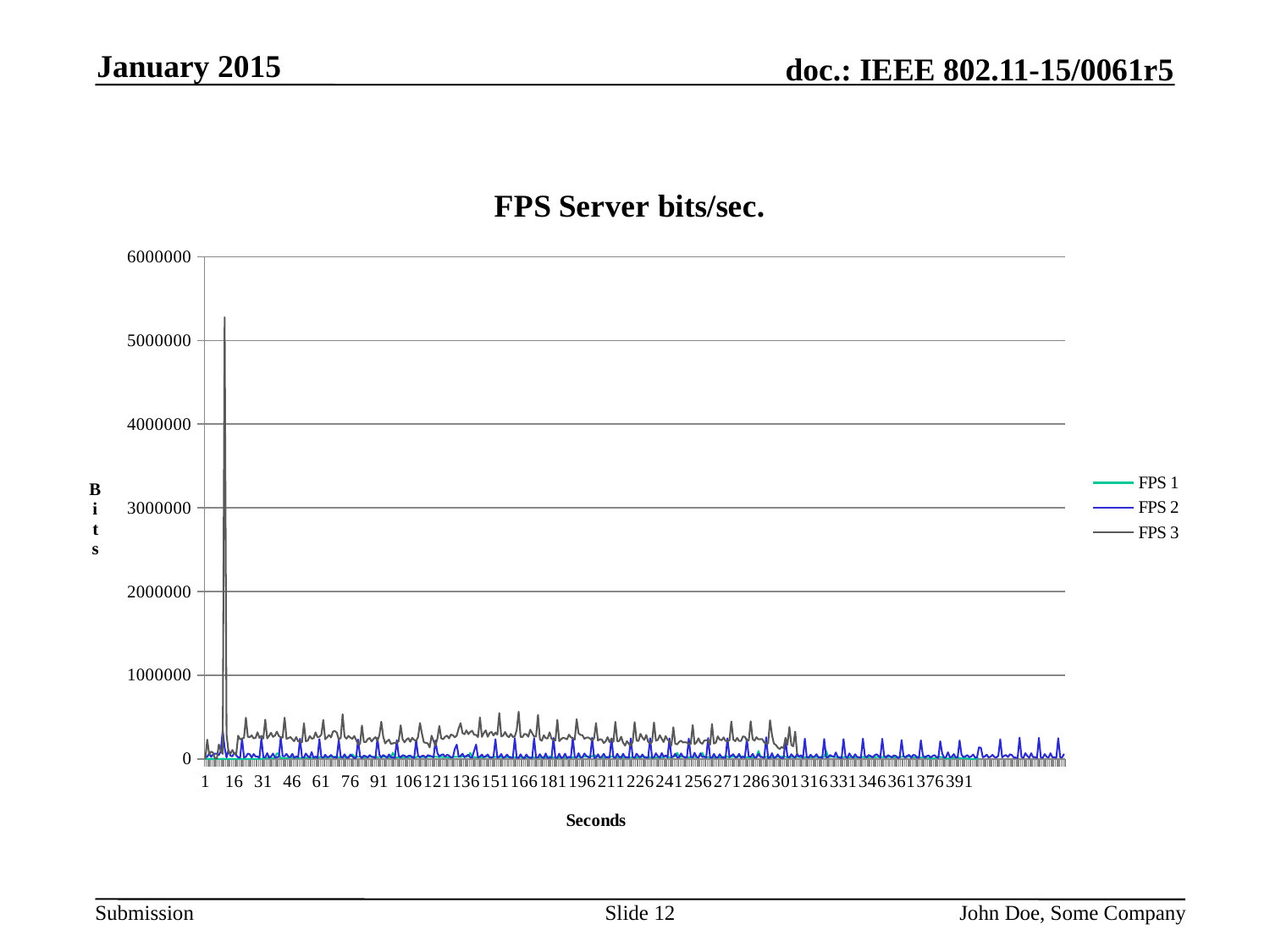
Which series reaches the highest value on the chart? FPS 3 What is the title of the chart? FPS Server bits/sec. Which series has the larger peak value, FPS 2 or FPS 3? FPS 3 What are the names of the series listed in the legend? FPS 1, FPS 2, FPS 3 What kind of chart is shown on the slide? line chart Is the highest peak of the FPS 3 series greater or less than 5000000? greater How many series does the legend list? 3 Is the highest peak of the FPS 3 series greater or less than 6000000? less What is the label of the horizontal axis? Seconds Is the highest value of the FPS 2 series greater or less than 1000000? less What is the highest value shown on the vertical axis? 6000000